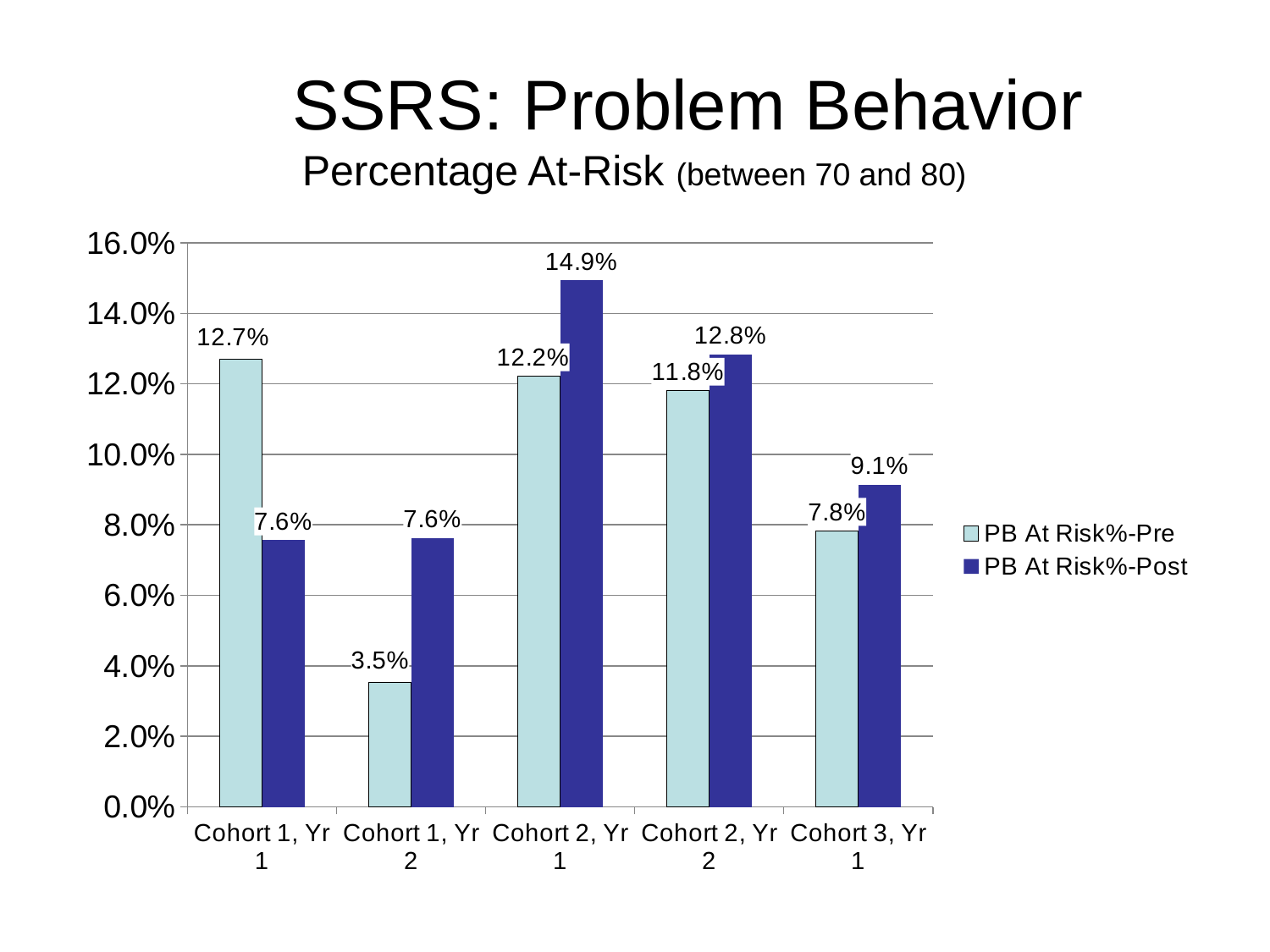
Which category has the lowest PB At Risk%-Pre value? Cohort 1, Yr 2 For Cohort 2, Yr 2, which is larger: the PB At Risk%-Pre value or the PB At Risk%-Post value? PB At Risk%-Post What is the PB At Risk%-Post value for Cohort 2, Yr 1? 14.9% How many categories are shown on the x axis? 5 Is the PB At Risk%-Pre value for Cohort 3, Yr 1 greater or less than 8.0%? less What is the difference between the PB At Risk%-Pre and PB At Risk%-Post values for Cohort 1, Yr 1? 5.1% What is the PB At Risk%-Pre value for Cohort 1, Yr 2? 3.5% What is the PB At Risk%-Pre value for Cohort 1, Yr 1? 12.7% Which category has the highest PB At Risk%-Post value? Cohort 2, Yr 1 How many series does the legend list? 2 What is the PB At Risk%-Post value for Cohort 3, Yr 1? 9.1% What kind of chart is shown on the slide? bar chart